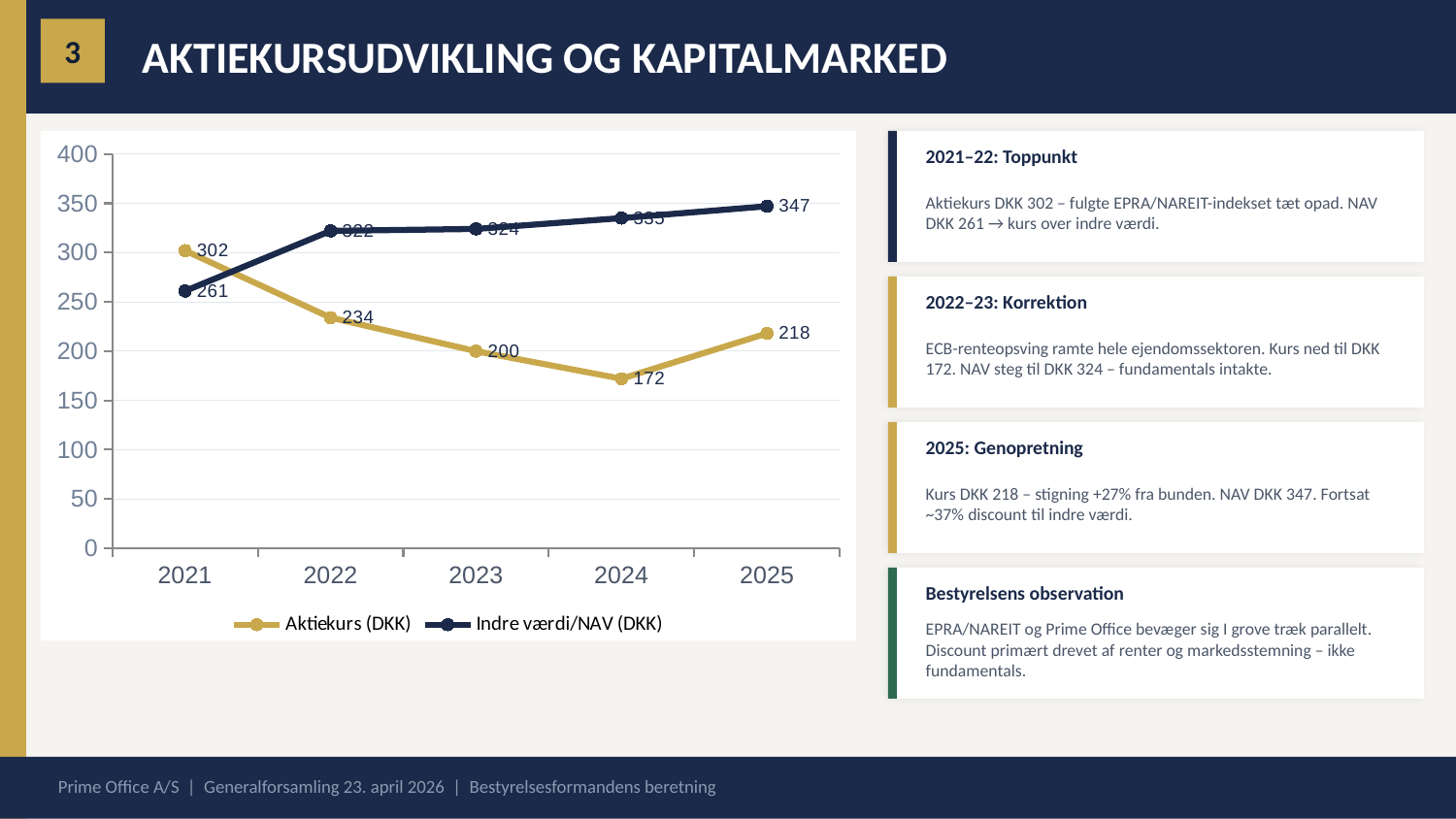
What is the Indre værdi/NAV (DKK) value for 2021? 261 Does the Indre værdi/NAV (DKK) series rise or fall from 2021 to 2025? Rise What type of chart is shown on the slide? Line chart What is the difference between the Aktiekurs (DKK) in 2021 and in 2024? 130 How many years are shown on the x axis? 5 How many series does the legend list? 2 What is the Aktiekurs (DKK) value for 2024? 172 What is the Indre værdi/NAV (DKK) value for 2025? 347 In which year is the Indre værdi/NAV (DKK) highest? 2025 What is the Aktiekurs (DKK) value for 2021? 302 Which is larger in 2021, the Aktiekurs (DKK) or the Indre værdi/NAV (DKK)? Aktiekurs (DKK) In which year is the Aktiekurs (DKK) lowest? 2024